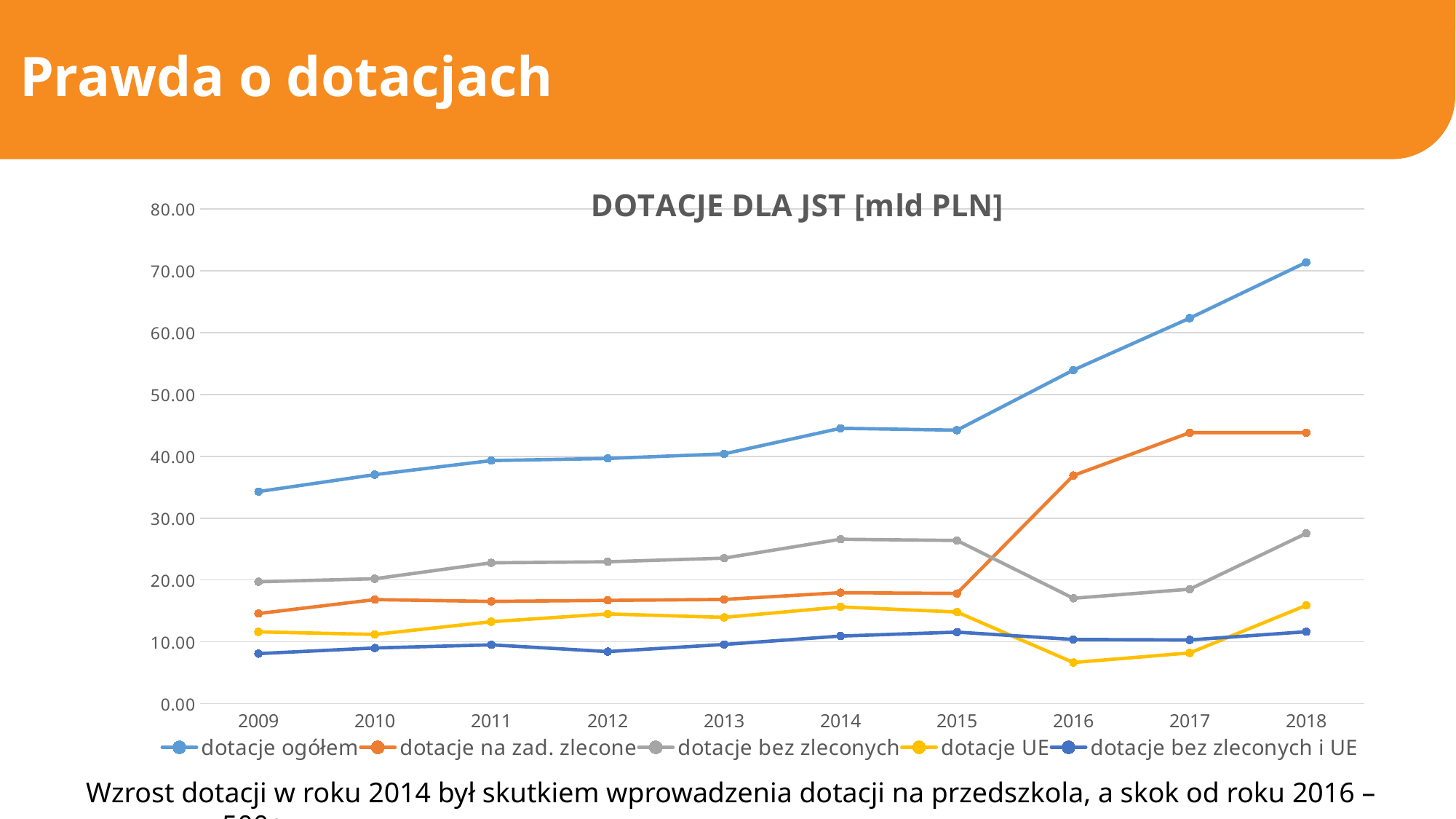
In 2015, which is larger: 'dotacje bez zleconych' or 'dotacje na zad. zlecone'? dotacje bez zleconych In which year is the value for 'dotacje ogółem' highest? 2018 How many years are shown on the x axis? 10 Is the value for 'dotacje UE' in 2016 greater or less than 10.00? less What is the title of the chart? DOTACJE DLA JST [mld PLN] What kind of chart is shown on the slide? line chart In which year is the value for 'dotacje UE' lowest? 2016 In 2016, which is larger: 'dotacje na zad. zlecone' or 'dotacje bez zleconych'? dotacje na zad. zlecone How many series does the legend list? 5 Is the value for 'dotacje na zad. zlecone' in 2016 greater or less than 30.00? greater Does the value for 'dotacje ogółem' rise or fall from 2009 to 2018? rises Is the value for 'dotacje ogółem' in 2018 greater or less than 60.00? greater